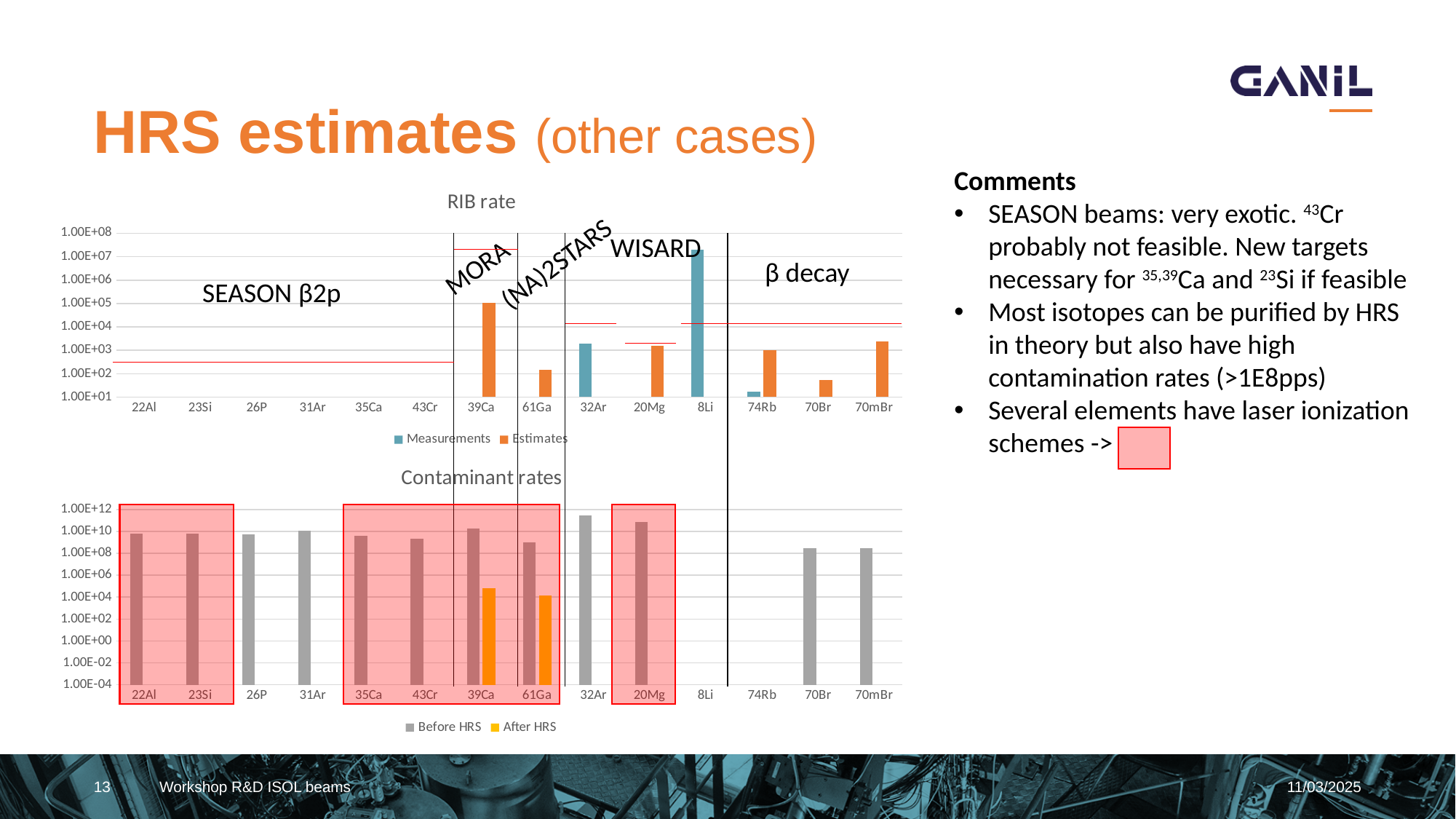
How many categories are shown on the x axis of the "Contaminant rates" chart? 14 How many series does the legend of the "RIB rate" chart list? 2 In the "RIB rate" chart, which category has the highest bar overall? 8Li In the "RIB rate" chart, is the Measurements value for 8Li greater or less than 1.00E+06? greater In the "RIB rate" chart, which category has the highest Estimates bar? 39Ca In the "RIB rate" chart, is the Estimates value for 39Ca greater or less than 1.00E+04? greater In the "Contaminant rates" chart, is the After HRS value for 39Ca greater or less than 1.00E+04? greater In the "Contaminant rates" chart, which is larger: the After HRS value for 39Ca or for 61Ga? 39Ca In the "Contaminant rates" chart, which category has the highest Before HRS bar? 32Ar What kind of chart is the "RIB rate" chart? bar chart What are the two legend entries of the "Contaminant rates" chart? Before HRS, After HRS